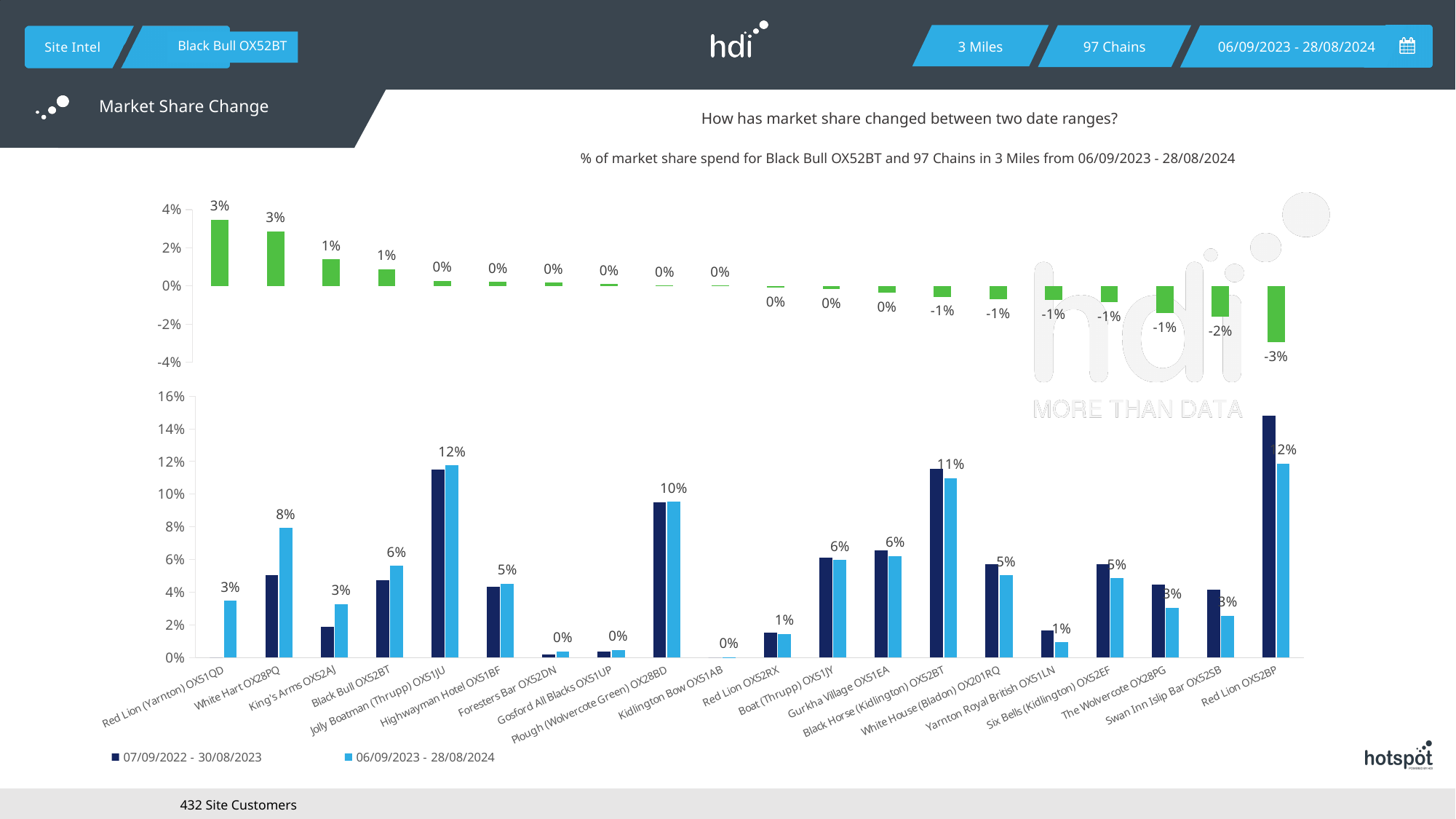
In the bottom chart, what is the value for White Hart OX28PQ in the 06/09/2023 - 28/08/2024 series? 8% How many categories are shown on the x axis of the bottom chart? 20 In the top chart (market share change), which category has the lowest value? Red Lion OX52BP How many series does the legend of the bottom chart list? 2 In the bottom chart, which is larger in the 06/09/2023 - 28/08/2024 series: Plough (Wolvercote Green) OX28BD or Black Bull OX52BT? Plough (Wolvercote Green) OX28BD In the bottom chart, what is the value for Plough (Wolvercote Green) OX28BD in the 06/09/2023 - 28/08/2024 series? 10% In the top chart (market share change), do the values rise or fall moving from left to right along the x axis? fall In the bottom chart, is the value for Red Lion OX52BP in the 07/09/2022 - 30/08/2023 series greater or less than 14%? greater In the top chart (market share change), what is the difference between the values for Red Lion (Yarnton) OX51QD and Red Lion OX52BP? 6 percentage points In the top chart (market share change), what is the value for Red Lion (Yarnton) OX51QD? 3% In the bottom chart, is the value for Jolly Boatman (Thrupp) OX51JU in the 07/09/2022 - 30/08/2023 series greater or less than 10%? greater In the top chart (market share change), what is the value for Red Lion OX52BP? -3%